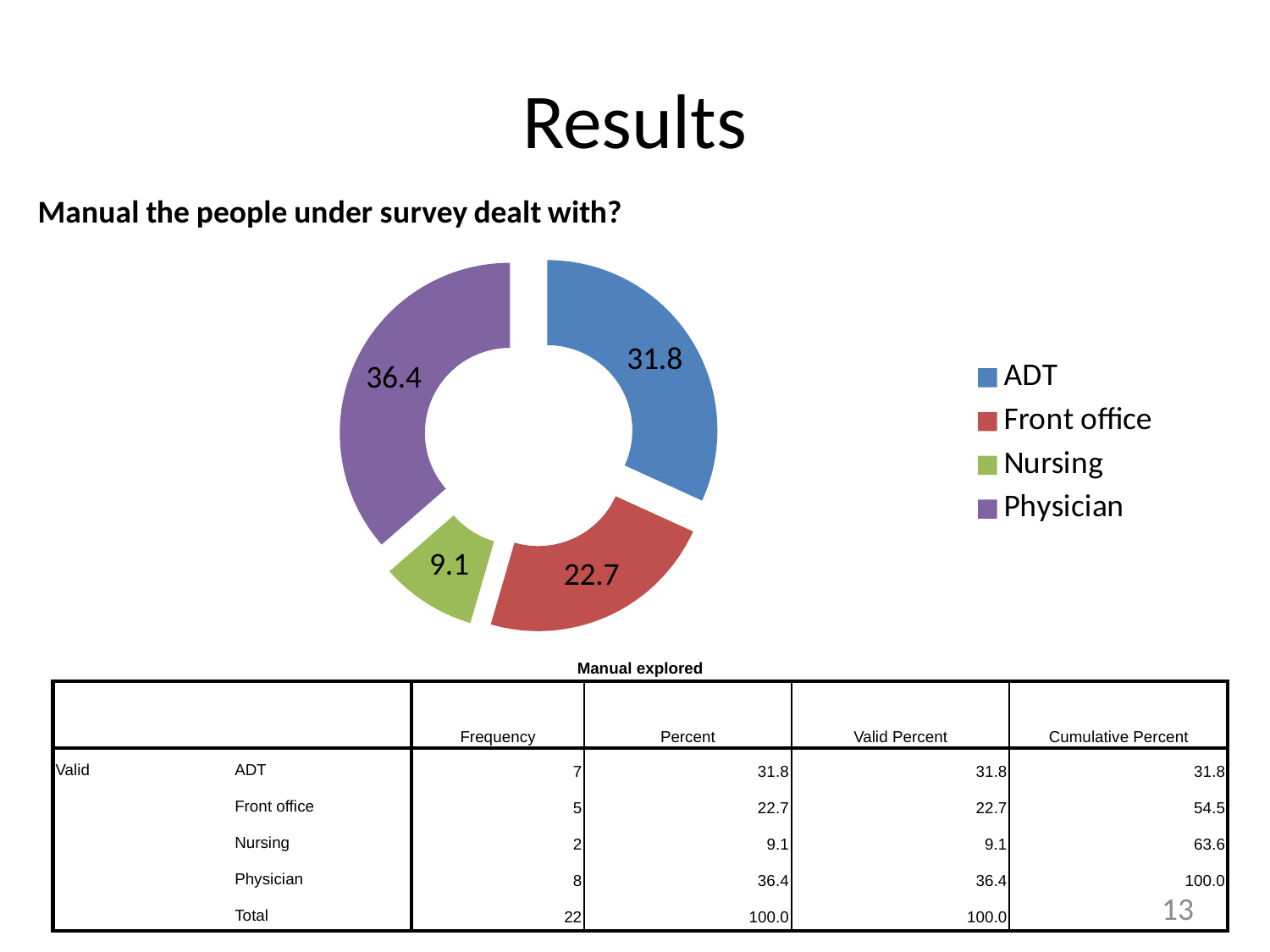
What value is shown for the Nursing slice of the doughnut chart? 9.1 What value is shown for the Front office slice of the doughnut chart? 22.7 What value is shown for the ADT slice of the doughnut chart? 31.8 Which category has the largest slice in the doughnut chart? Physician Which category has the smallest slice in the doughnut chart? Nursing Which legend entry is listed first in the doughnut chart's legend? ADT What colour is the Physician slice in the doughnut chart? Purple What value is shown for the Physician slice of the doughnut chart? 36.4 How many categories does the doughnut chart show? 4 Which is larger in the doughnut chart, Front office or Nursing? Front office What kind of chart is shown on the slide? Doughnut chart What is the difference between the Physician and ADT values in the doughnut chart? 4.6